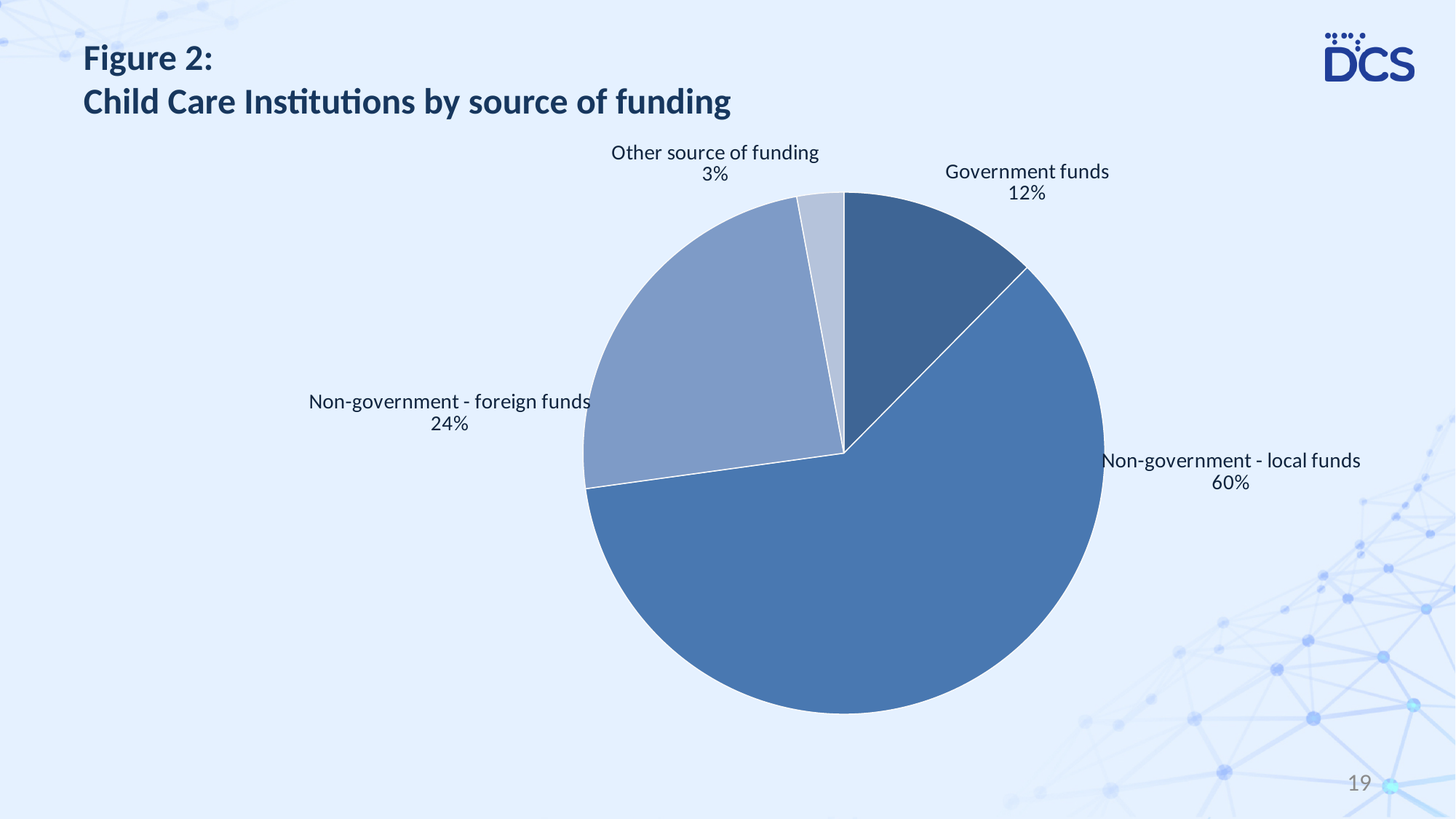
What share of child care institutions is funded by Non-government - local funds? 60% What share of child care institutions is funded by Non-government - foreign funds? 24% Which source of funding has the largest share? Non-government - local funds How many funding sources are shown in the pie chart? 4 What share of child care institutions has Other source of funding? 3% What share of child care institutions is funded by Government funds? 12% Which is larger: the share for Government funds or the share for Non-government - foreign funds? Non-government - foreign funds What is the difference in percentage points between Government funds and Other source of funding? 9 What is the title of the chart? Child Care Institutions by source of funding What kind of chart is shown on the slide? pie chart Which source of funding has the smallest share? Other source of funding What is the difference in percentage points between Non-government - local funds and Non-government - foreign funds? 36